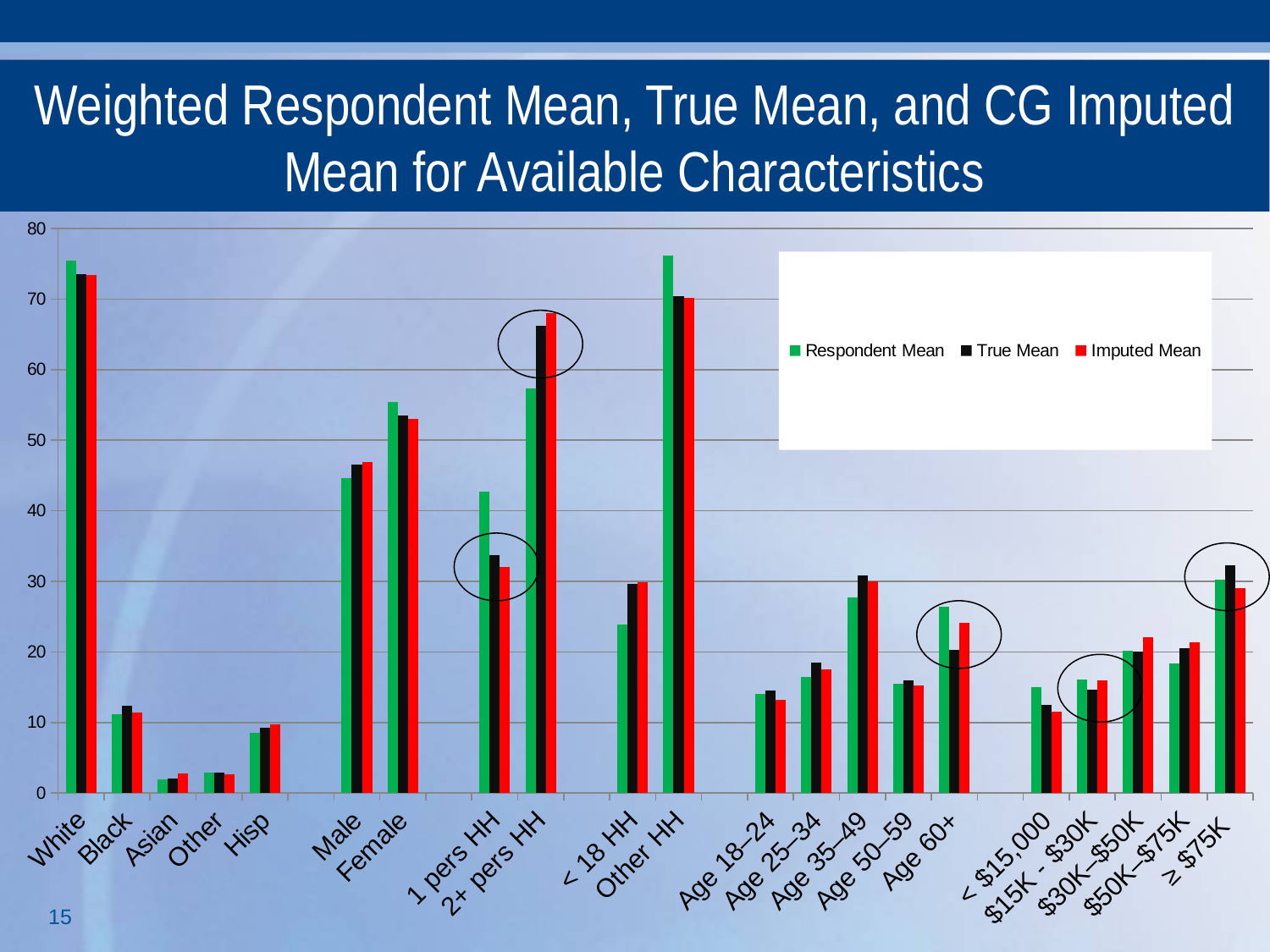
For 1 pers HH, which is larger: the Respondent Mean or the True Mean? Respondent Mean For Age 60+, which is larger: the Respondent Mean or the True Mean? Respondent Mean Is the Respondent Mean for White greater or less than 70? greater How many series does the legend list? 3 What kind of chart is shown on the slide? Bar chart Is the True Mean for ≥ $75K greater or less than 30? greater Which colour represents the Imputed Mean series in the legend? Red Is the True Mean for 2+ pers HH greater or less than 60? greater How many categories are shown along the x axis? 21 Which category has the highest True Mean? White Which category has the lowest True Mean? Asian